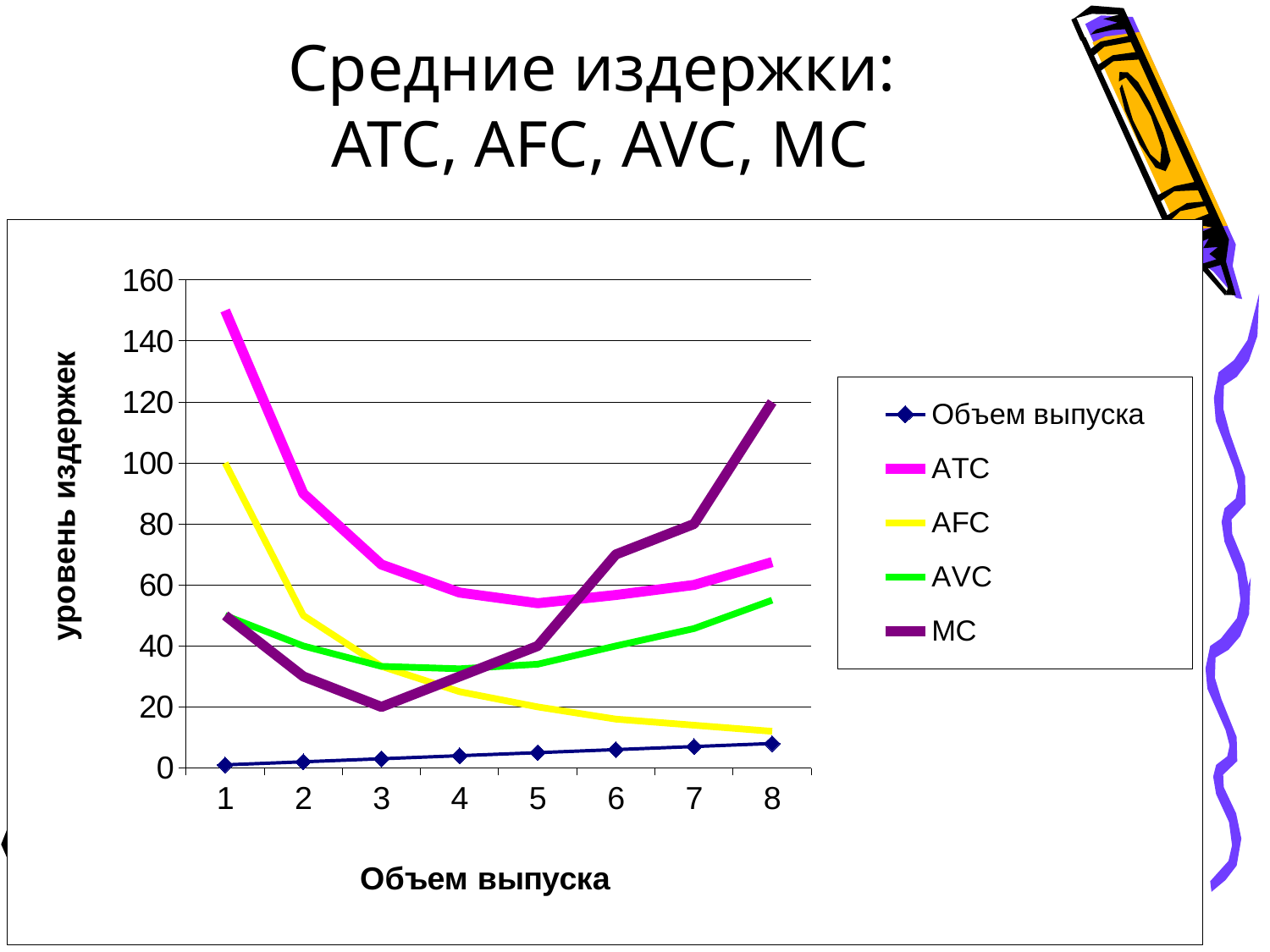
How many output levels (points) are plotted along the x axis? 8 What is the title of the vertical axis? уровень издержек What is the value of AFC at output level 1? 100 Does the Объем выпуска series rise or fall along the x axis? rises What is the value of MC at output level 3? 20 What type of chart is shown on the slide? line chart Which series has the highest value at output level 1? ATC Is the value of AFC at output level 8 greater or less than 20? less At output level 8, which is larger: MC or ATC? MC Is the value of ATC at output level 1 greater or less than 140? greater How many series does the legend list? 5 Does the AFC curve rise or fall as output increases from 1 to 8? falls